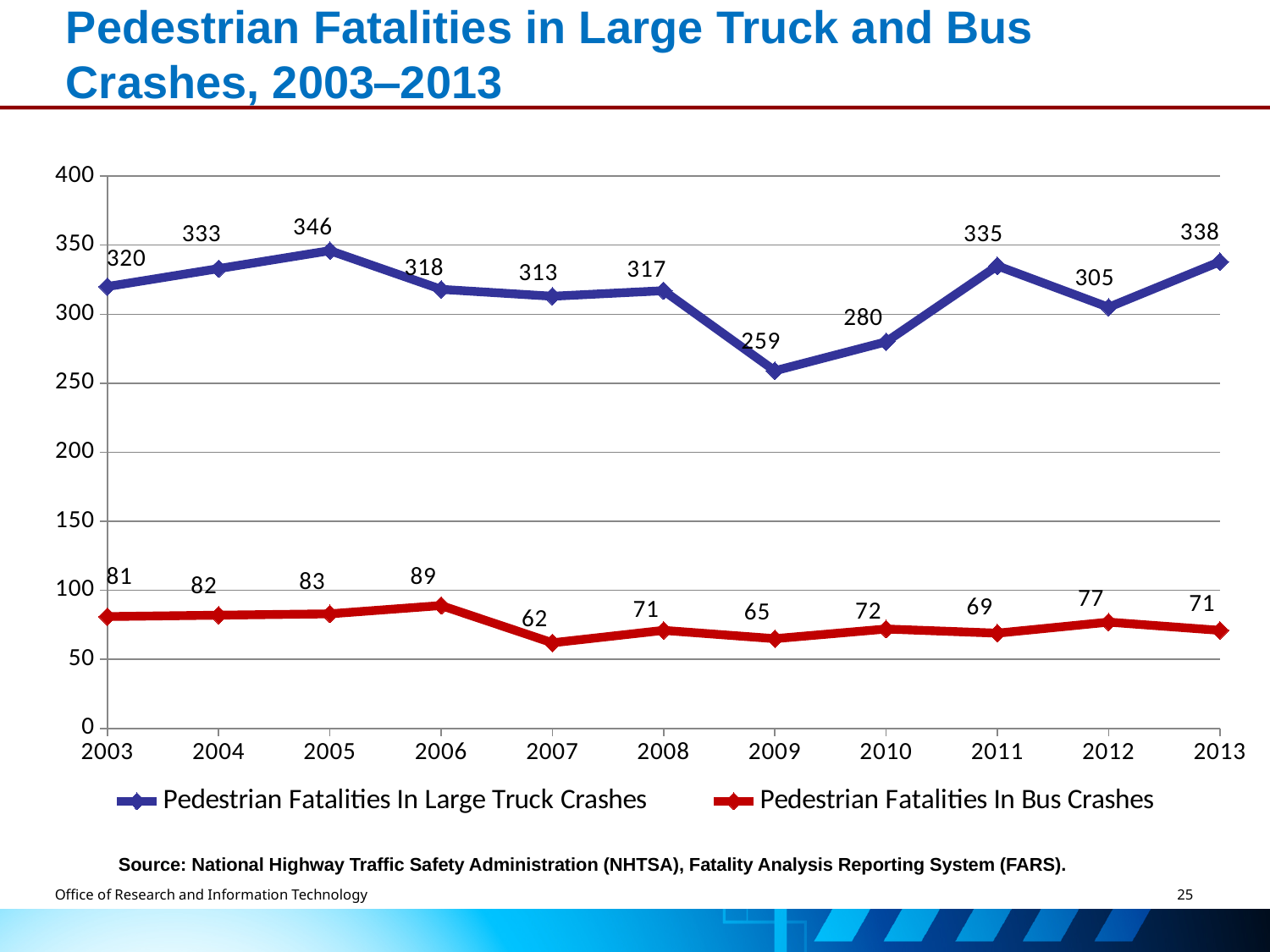
What was the number of pedestrian fatalities in bus crashes in 2006? 89 Which year had more pedestrian fatalities in large truck crashes, 2011 or 2012? 2011 In which year were pedestrian fatalities in bus crashes lowest? 2007 Did pedestrian fatalities in large truck crashes rise or fall from 2008 to 2009? Fall How many years are shown on the x axis? 11 What colour is the line for pedestrian fatalities in bus crashes? Red In which year were pedestrian fatalities in large truck crashes highest? 2005 What is the difference between pedestrian fatalities in large truck crashes and in bus crashes in 2013? 267 How many series does the legend list? 2 What is the difference in pedestrian fatalities in bus crashes between 2006 and 2007? 27 What was the number of pedestrian fatalities in large truck crashes in 2009? 259 What kind of chart is shown on the slide? Line chart